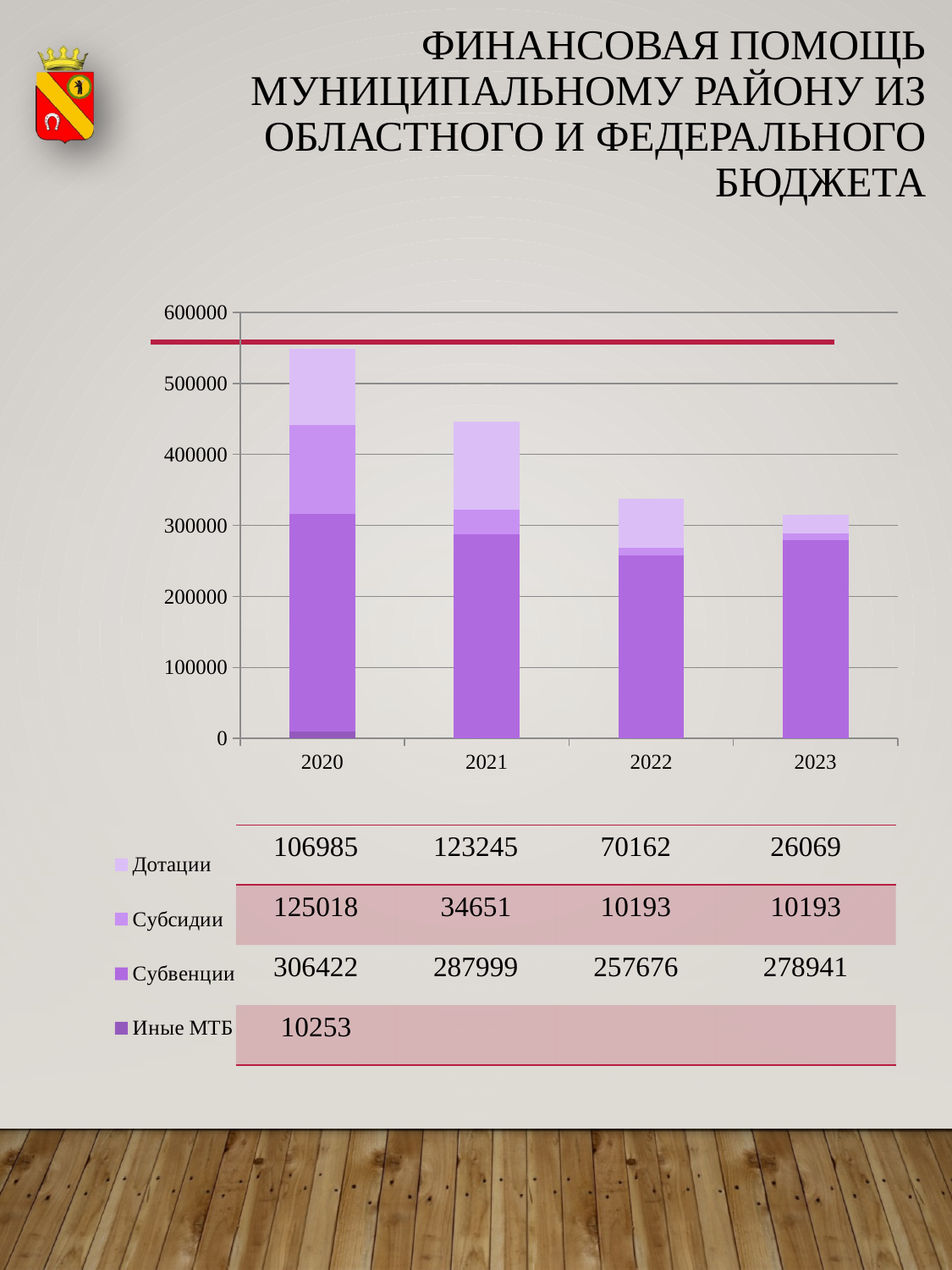
What is the total of the stacked bar for 2021? 445895 What type of chart is shown on the slide? stacked bar chart In which year is Субвенции lowest? 2022 What is the value of Дотации for 2023? 26069 How many series does the legend list? 4 Does the total height of the stacked bars rise or fall from 2020 to 2022? fall What is the difference between Дотации in 2021 and Дотации in 2022? 53083 How many years are shown on the x axis? 4 What is the value of Иные МТБ for 2020? 10253 Which is larger: Субсидии in 2020 or Дотации in 2020? Субсидии in 2020 What is the value of Субвенции for 2021? 287999 In which year is Субсидии highest? 2020